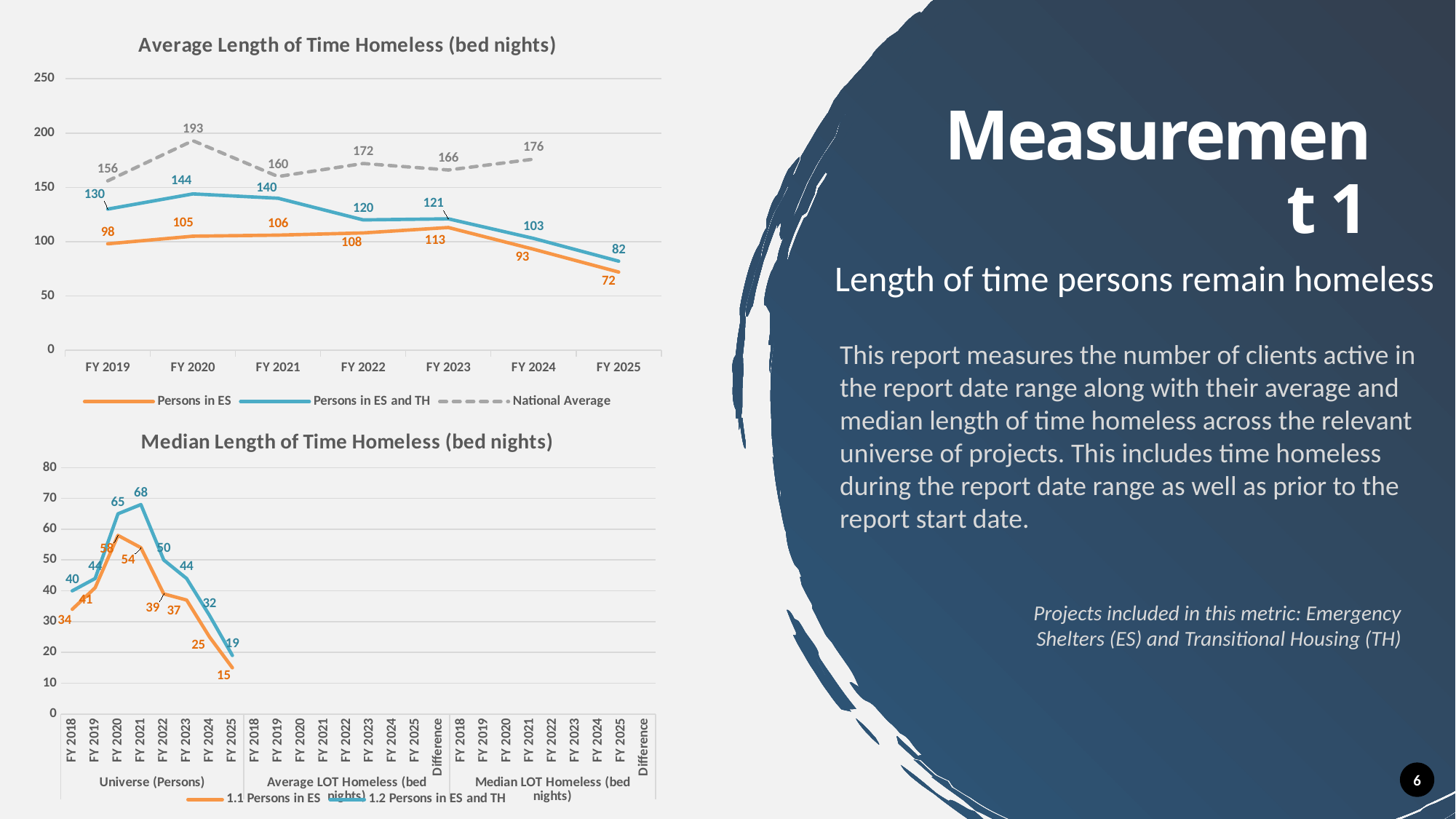
How many series does the legend of the Average Length of Time Homeless chart list? 3 In the Average Length of Time Homeless chart, what is the National Average value for FY 2020? 193 In the Average Length of Time Homeless chart, which fiscal year has the lowest value for Persons in ES? FY 2025 In the Average Length of Time Homeless chart, what is the value for Persons in ES and TH in FY 2025? 82 In the Average Length of Time Homeless chart, what is the difference between the National Average and Persons in ES and TH in FY 2019? 26 In the Average Length of Time Homeless chart, which is larger in FY 2022: Persons in ES or Persons in ES and TH? Persons in ES and TH In the Median Length of Time Homeless chart, what is the highest value shown for Persons in ES and TH? 68 What kind of chart is the Median Length of Time Homeless chart? Line chart How many fiscal years are shown on the x axis of the Average Length of Time Homeless chart? 7 In the Median Length of Time Homeless chart, what is the lowest value shown for Persons in ES? 15 In the Average Length of Time Homeless chart, what is the value for Persons in ES in FY 2023? 113 In the Average Length of Time Homeless chart, which fiscal year has the highest value for Persons in ES and TH? FY 2020